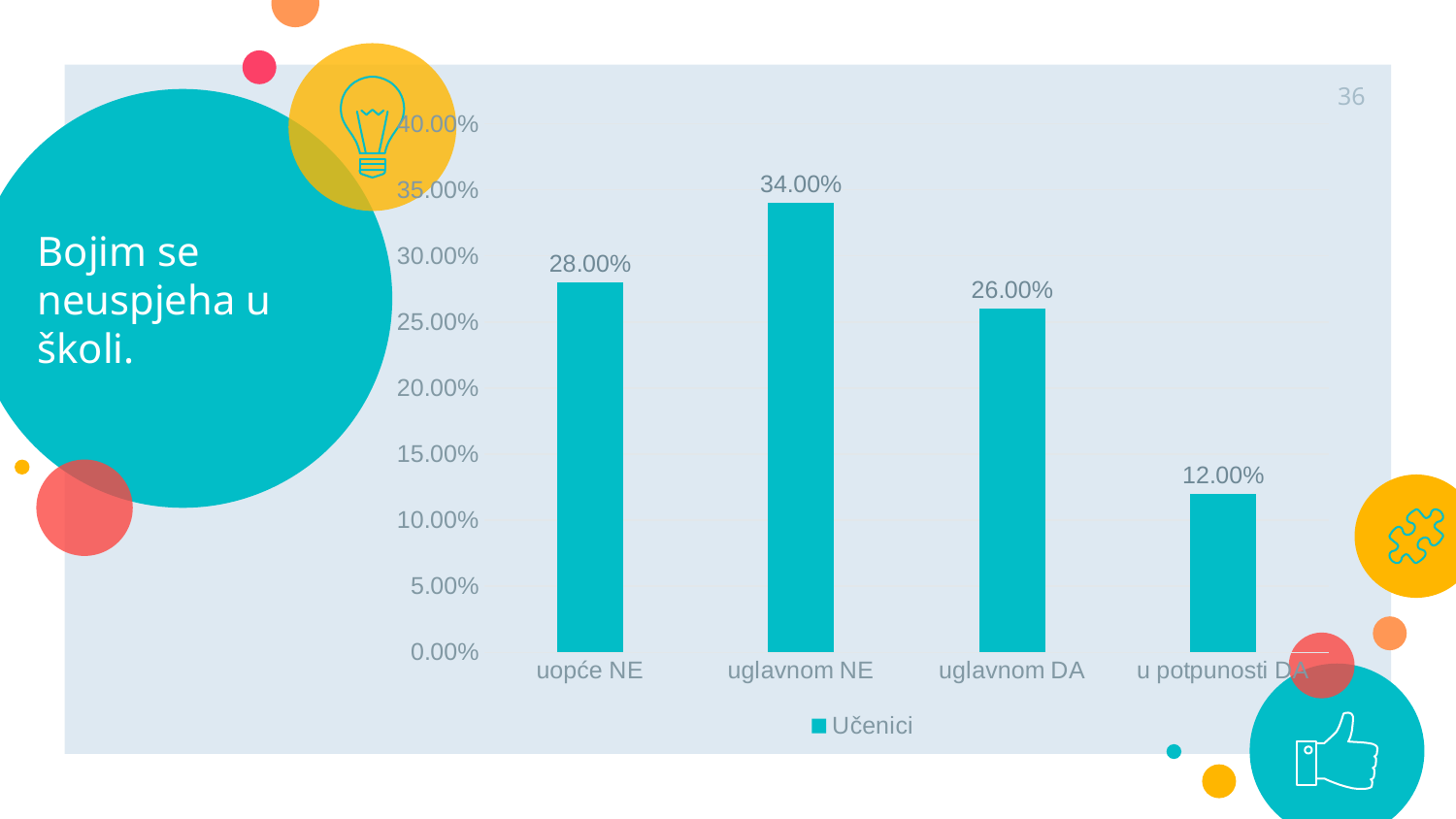
How many categories are shown on the x axis? 4 Is the value for 'uglavnom DA' greater or less than 30.00%? less What is the value for 'uglavnom NE'? 34.00% What kind of chart is shown? bar chart What is the value for 'uopće NE'? 28.00% Which category has the lowest value? u potpunosti DA Which category has the highest value? uglavnom NE What is the value for 'u potpunosti DA'? 12.00% How many series does the legend list? 1 What is the name of the series shown in the legend? Učenici Which is larger, the value for 'uopće NE' or 'uglavnom DA'? uopće NE What is the difference between the values for 'uglavnom NE' and 'uglavnom DA'? 8.00%